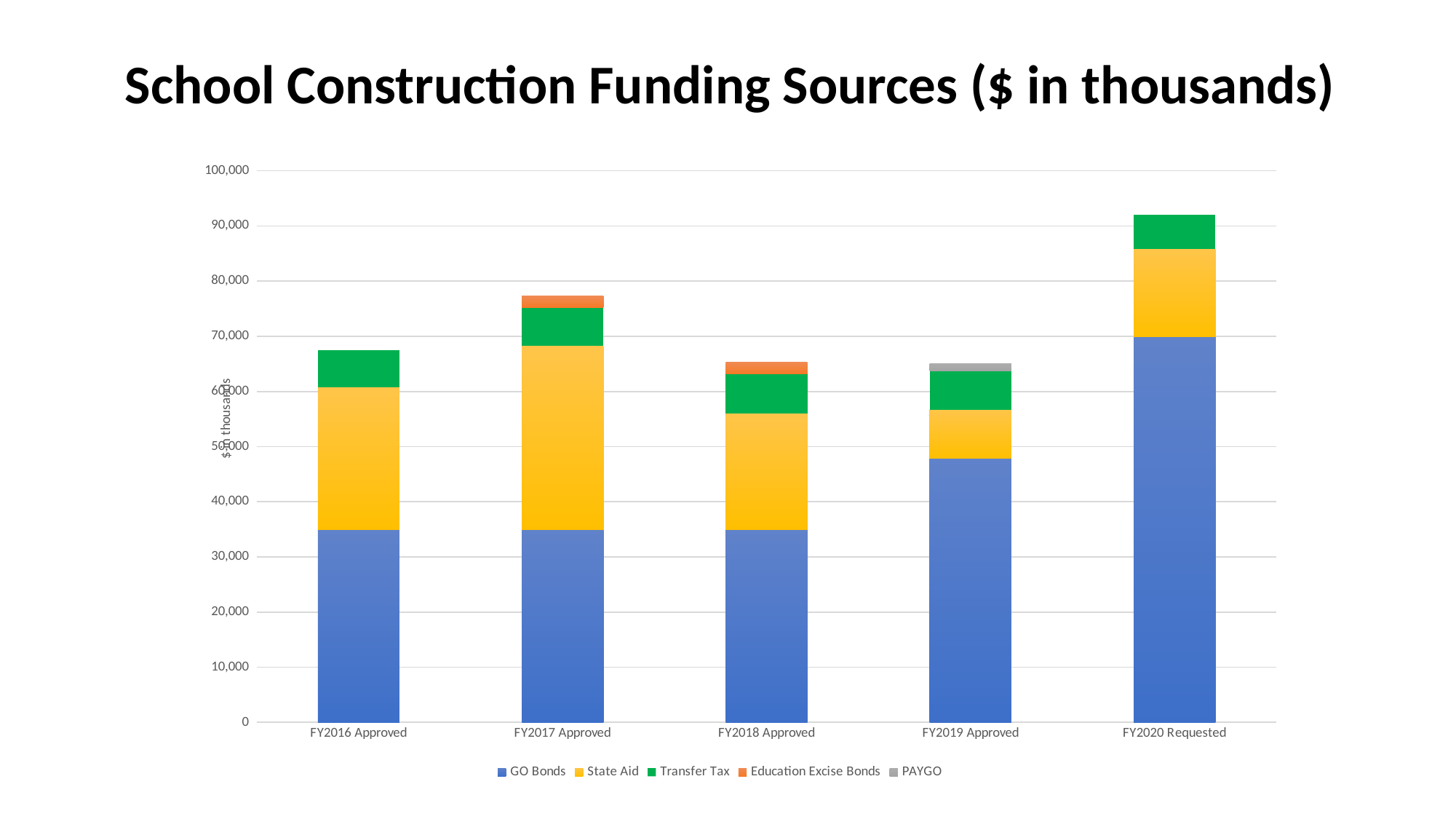
What is the title of the chart? School Construction Funding Sources ($ in thousands) Is the GO Bonds value for FY2020 Requested greater or less than 60,000? greater How many series does the legend list? 5 Which fiscal year has the highest total funding? FY2020 Requested Is the total funding for FY2016 Approved greater or less than 70,000? less How many fiscal-year categories are shown on the x axis? 5 Is the GO Bonds value for FY2019 Approved greater or less than 50,000? less Does the total funding rise or fall from FY2019 Approved to FY2020 Requested? rise Which has the larger total funding, FY2016 Approved or FY2017 Approved? FY2017 Approved Which series forms the bottom segment of each stacked bar? GO Bonds What kind of chart is shown on the slide? Stacked bar chart